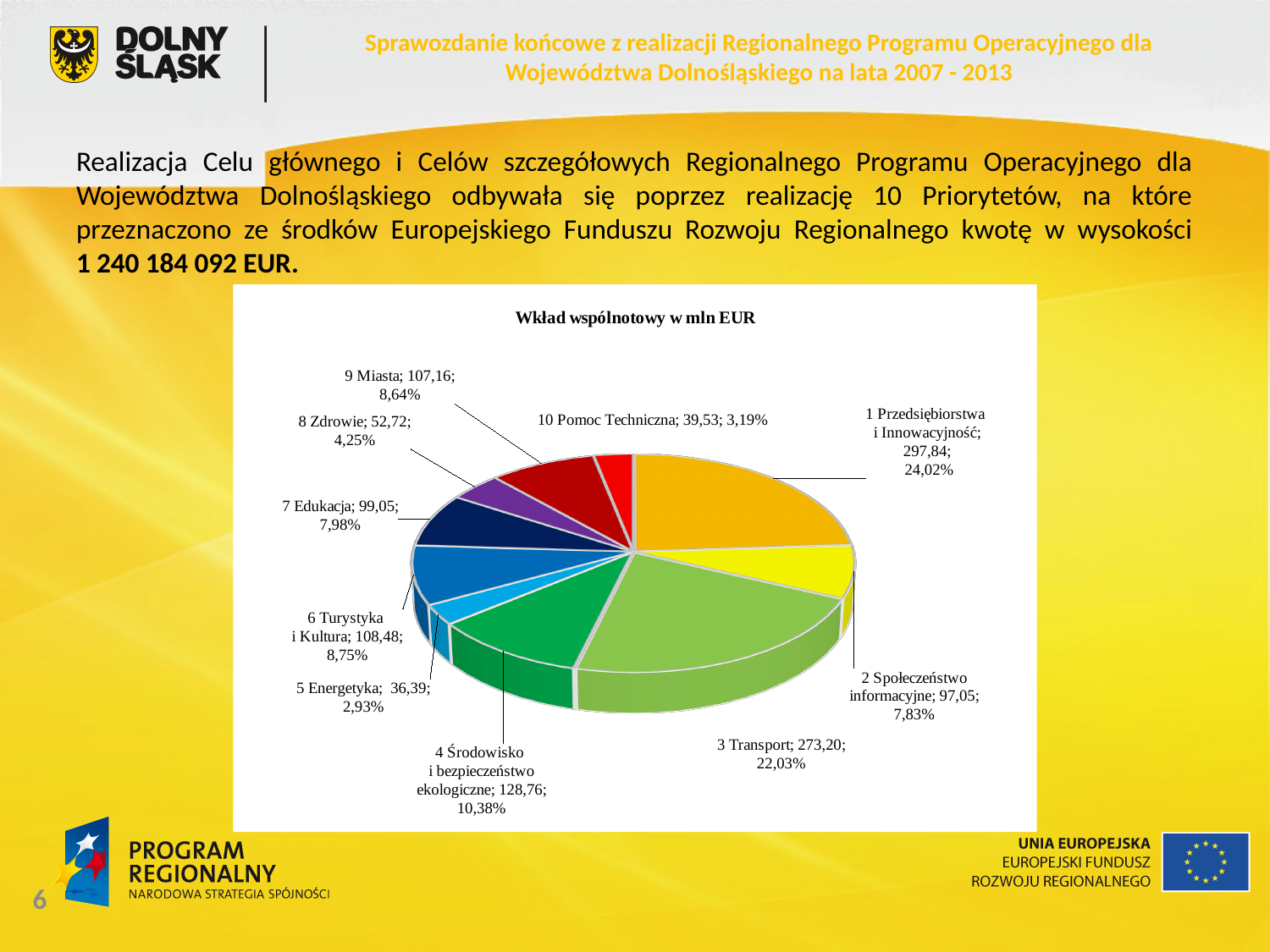
How many slices does the pie chart have? 10 What is the title of the chart? Wkład wspólnotowy w mln EUR What is the difference between the values for 1 Przedsiębiorstwa i Innowacyjność and 3 Transport? 24,64 What is the value shown for 9 Miasta? 107,16 What percentage share does 4 Środowisko i bezpieczeństwo ekologiczne have? 10,38% Which is larger, the value for 6 Turystyka i Kultura or the value for 7 Edukacja? 6 Turystyka i Kultura What is the value shown for 8 Zdrowie? 52,72 Which category has the smallest slice of the pie? 5 Energetyka What percentage share does 10 Pomoc Techniczna have? 3,19% What is the value shown for 3 Transport? 273,20 Which category has the largest slice of the pie? 1 Przedsiębiorstwa i Innowacyjność What kind of chart is shown on the slide? pie chart